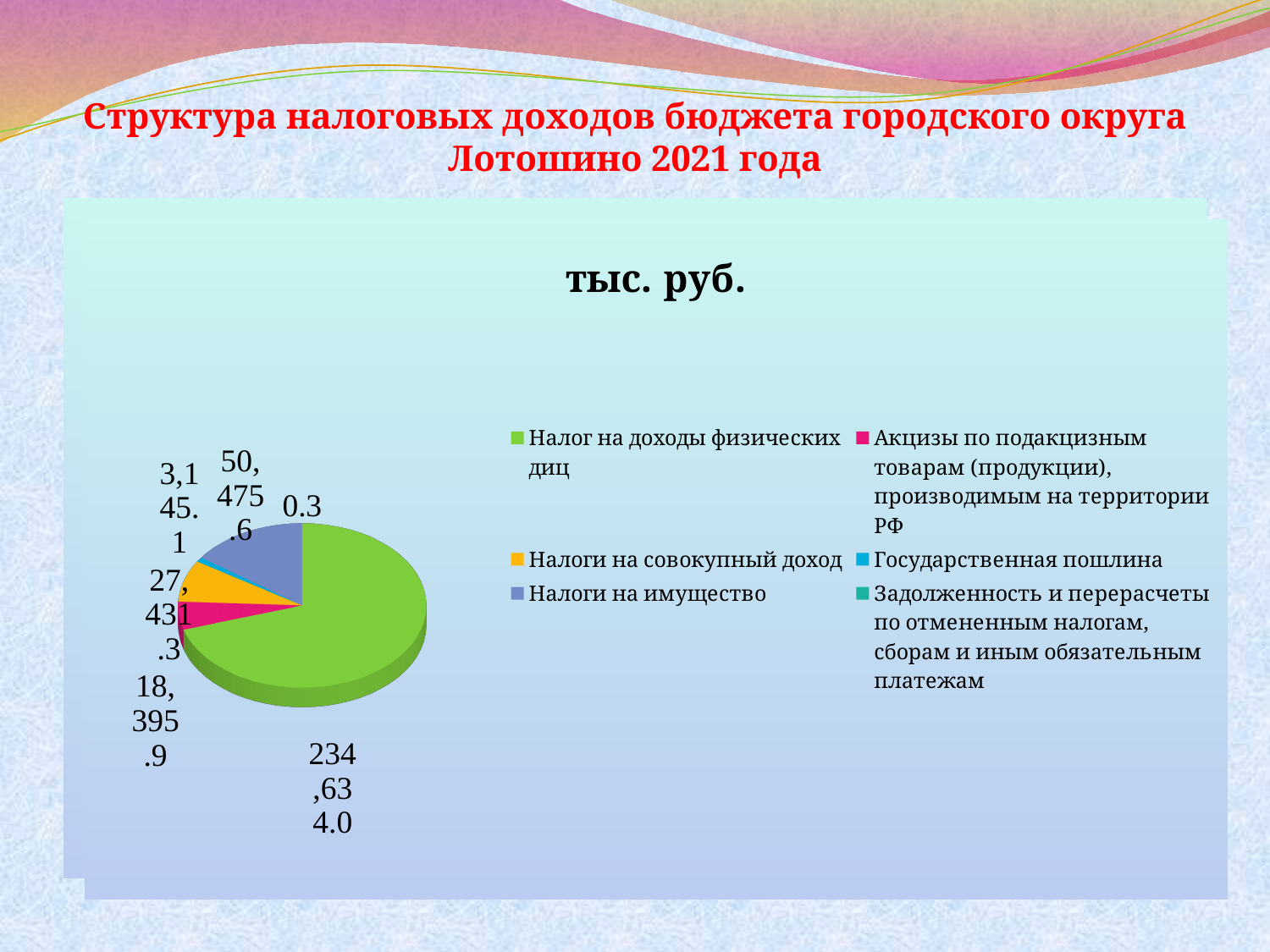
What is the value for Налог на доходы физических лиц? 234,634.0 Which category has the smallest value in the pie chart? Задолженность и перерасчеты по отмененным налогам, сборам и иным обязательным платежам What kind of chart is shown on the slide? pie chart What unit is given in the chart title above the pie? тыс. руб. What is the value for Налоги на совокупный доход? 27,431.3 What is the value for Акцизы по подакцизным товарам (продукции), производимым на территории РФ? 18,395.9 Which is larger: Налоги на имущество or Налоги на совокупный доход? Налоги на имущество What is the value for Налоги на имущество? 50,475.6 Which category has the largest slice of the pie chart? Налог на доходы физических диц What is the value for Государственная пошлина? 3,145.1 How many categories does the legend of the pie chart list? 6 What is the difference between the values for Налоги на имущество and Налоги на совокупный доход? 23,044.3